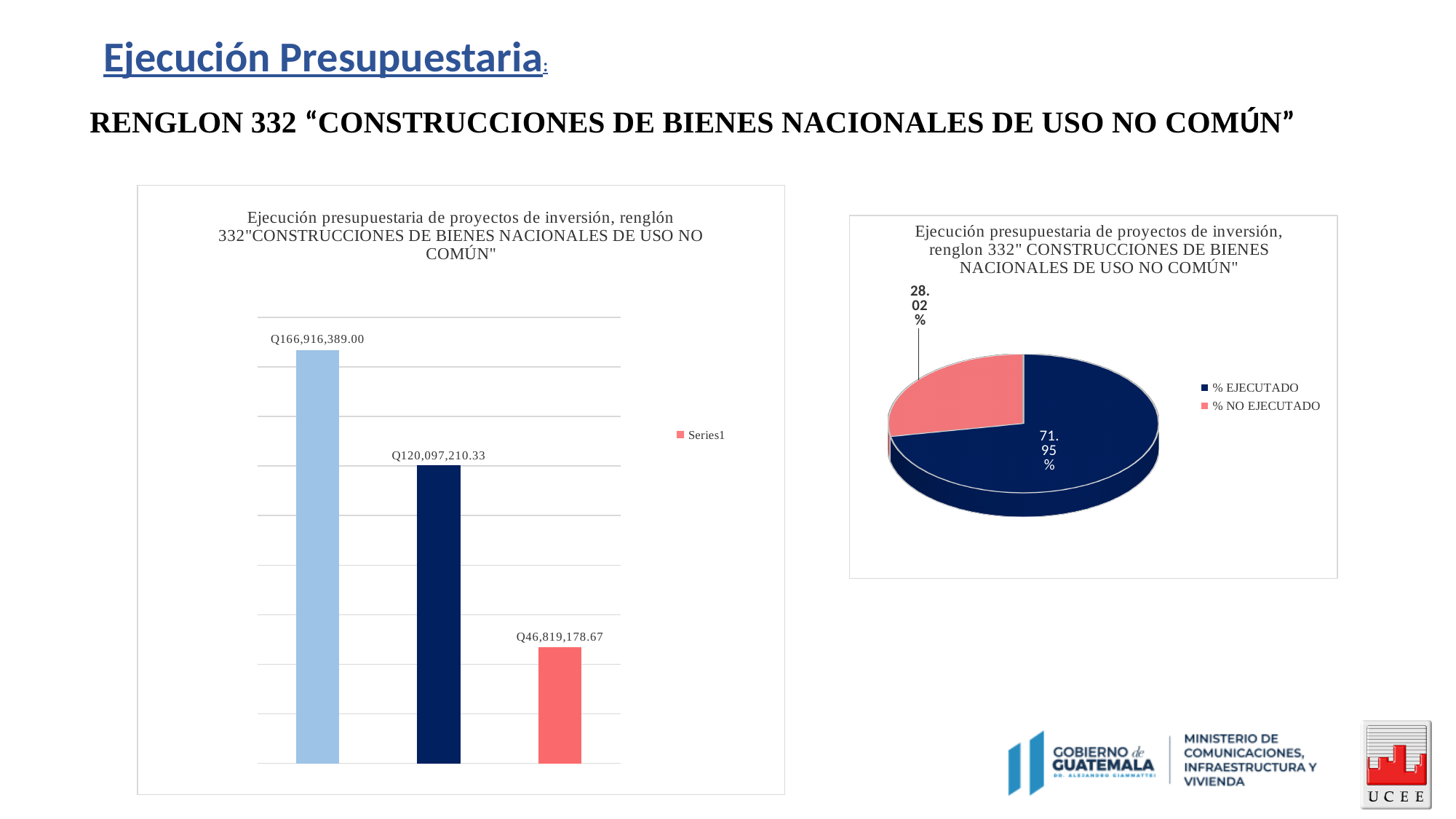
In the bar chart on the left, what is the difference between the second bar (Q120,097,210.33) and the third bar (Q46,819,178.67)? Q73,278,031.66 What kind of chart is the chart on the right of the slide? Pie chart In the bar chart on the left, what is the value shown on the tallest (first, light blue) bar? Q166,916,389.00 In the pie chart on the right, what share is labelled for % EJECUTADO? 71.95% In the pie chart on the right, which slice is larger, % EJECUTADO or % NO EJECUTADO? % EJECUTADO In the bar chart on the left, what is the name of the series listed in the legend? Series1 In the bar chart on the left, what is the difference between the first bar (Q166,916,389.00) and the second bar (Q120,097,210.33)? Q46,819,178.67 In the pie chart on the right, what share is labelled for % NO EJECUTADO? 28.02% In the bar chart on the left, what is the value shown on the dark blue (second) bar? Q120,097,210.33 In the bar chart on the left, how many bars are plotted? 3 In the bar chart on the left, what is the value shown on the shortest (third, red) bar? Q46,819,178.67 In the pie chart on the right, how many entries does the legend list? 2